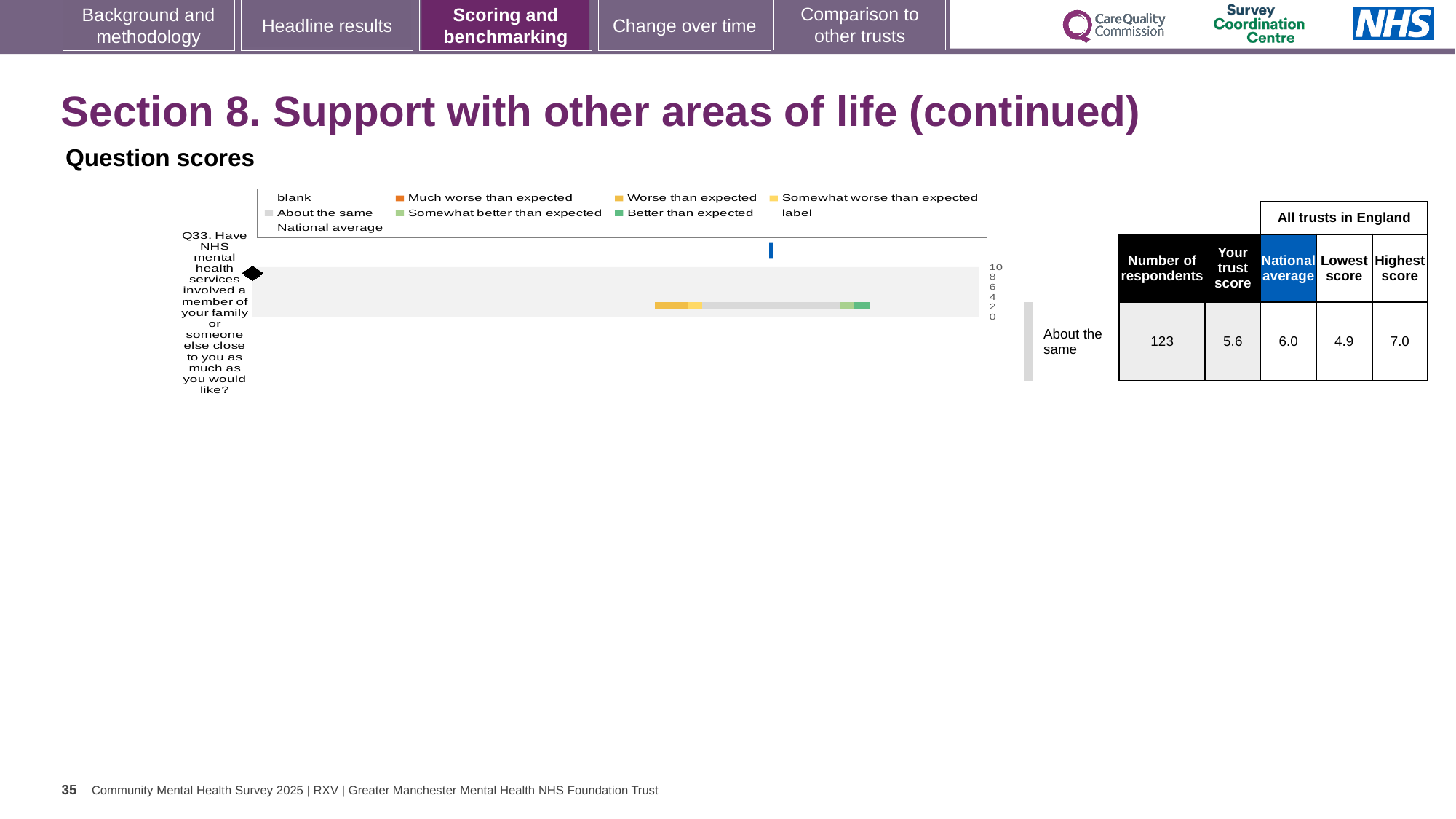
What is the heading above the chart? Question scores How many questions (categories) are plotted on the chart? 1 What is the lowest score among all trusts in England for Q33? 4.9 How many respondents answered Q33? 123 What is the highest score among all trusts in England for Q33? 7.0 What is the trust's score for Q33 according to the table next to the chart? 5.6 How many entries does the chart legend list? 9 What is the maximum value shown on the chart's axis? 10 Which question is plotted on the chart? Q33. Have NHS mental health services involved a member of your family or someone else close to you as much as you would like? What kind of chart is shown on the slide? bar chart What is the national average for Q33 according to the table next to the chart? 6.0 Which is larger for Q33, the trust score or the national average? national average